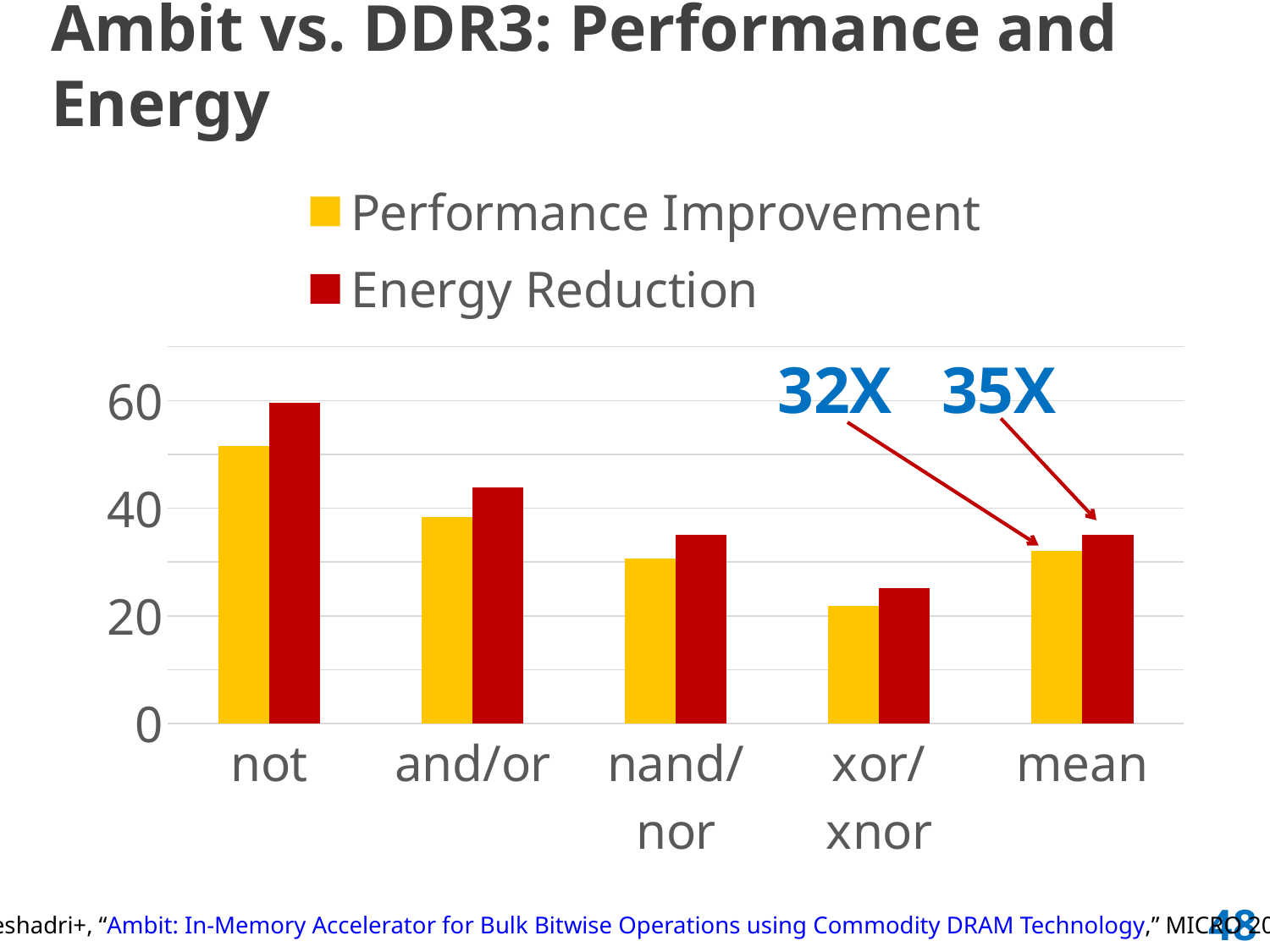
What is the mean Energy Reduction shown on the chart? 35X Which category has the lowest Energy Reduction? xor/xnor What is the mean Performance Improvement shown on the chart? 32X How many categories are shown on the x axis? 5 For the 'not' category, which is larger: Performance Improvement or Energy Reduction? Energy Reduction What colour represents Energy Reduction in the legend? red How many series does the legend list? 2 Is the Energy Reduction for 'xor/xnor' greater or less than 40? less What kind of chart is shown on the slide? bar chart Do the Energy Reduction values rise or fall from 'not' to 'xor/xnor'? fall Is the Performance Improvement for 'not' greater or less than 40? greater Which category has the highest Performance Improvement? not